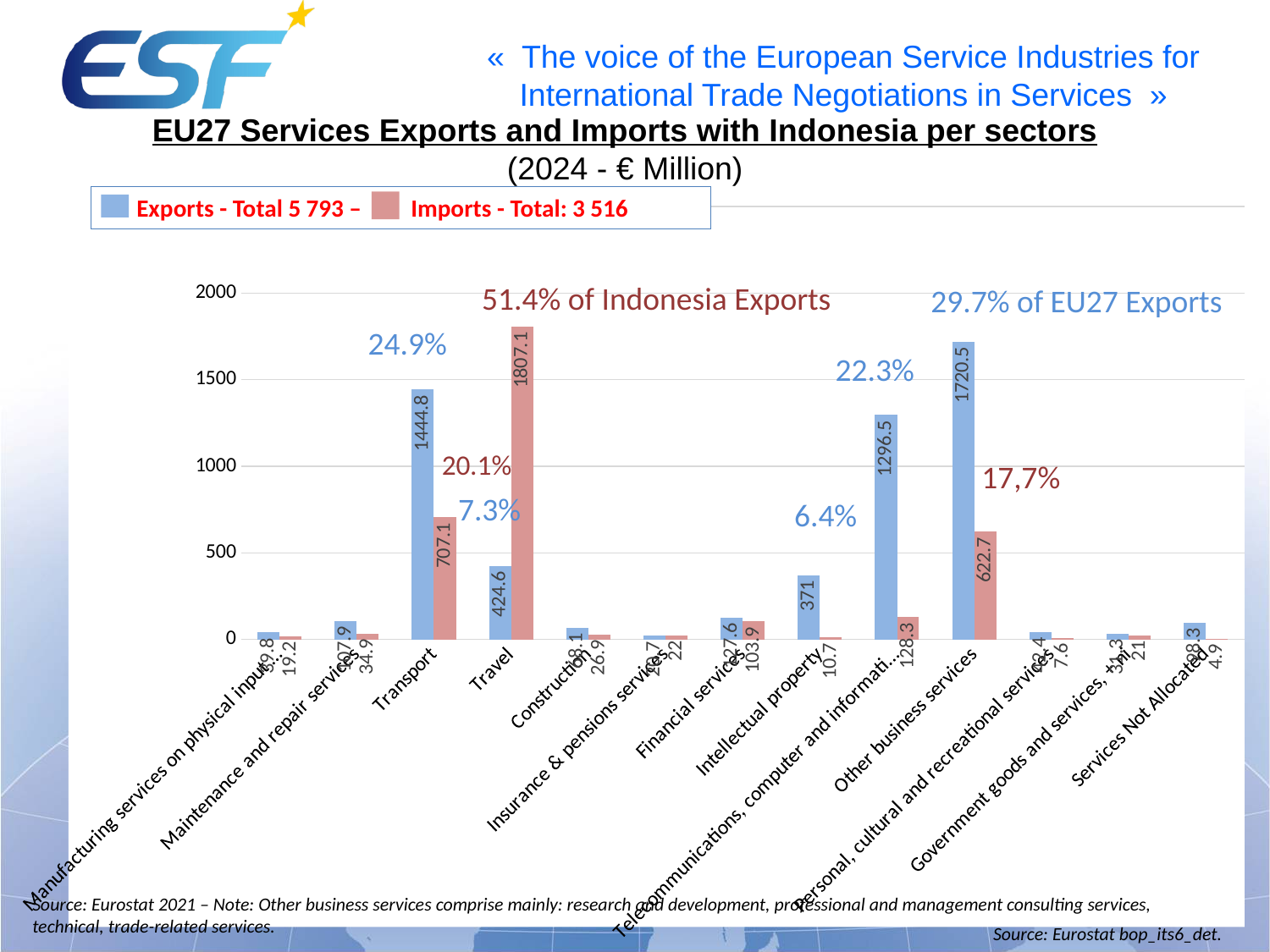
How many series does the legend list? 2 What is the difference between Imports and Exports for Travel? 1382.5 Which sector has the highest Imports value? Travel Which is larger: Exports for Transport or Exports for Travel? Exports for Transport What is the difference between Exports and Imports for Other business services? 1097.8 Is the Exports value for Telecommunications, computer and information services greater or less than 1000? greater What is the value of Imports for Intellectual property? 10.7 What is the value of Imports for Travel? 1807.1 How many sectors are shown on the x axis of the chart? 13 What kind of chart is shown on the slide? Bar chart What is the value of Exports for Transport? 1444.8 Which sector has the highest Exports value? Other business services